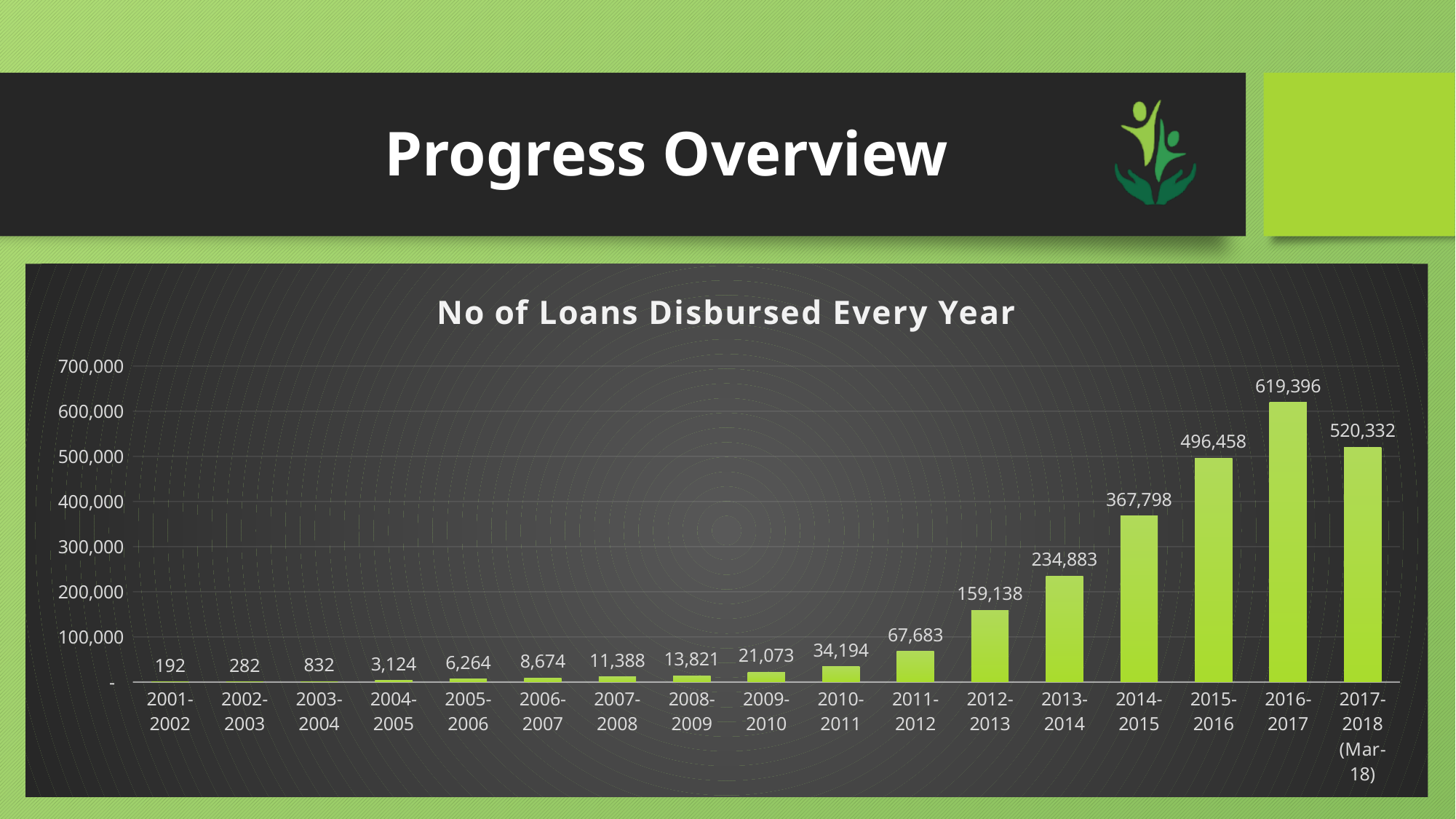
What is the title of the chart? No of Loans Disbursed Every Year What kind of chart is shown on the slide? Bar chart What is the number of loans disbursed in 2004-2005? 3,124 What is the difference between the number of loans disbursed in 2014-2015 and 2013-2014? 132,915 Which year has the highest number of loans disbursed? 2016-2017 What is the number of loans disbursed in 2016-2017? 619,396 Which year had more loans disbursed, 2015-2016 or 2017-2018 (Mar-18)? 2017-2018 (Mar-18) How many years are shown on the x axis of the chart? 17 What is the number of loans disbursed in 2010-2011? 34,194 What is the difference between the number of loans disbursed in 2016-2017 and 2017-2018 (Mar-18)? 99,064 Which year has the lowest number of loans disbursed? 2001-2002 Is the value for 2014-2015 greater or less than 300,000? greater